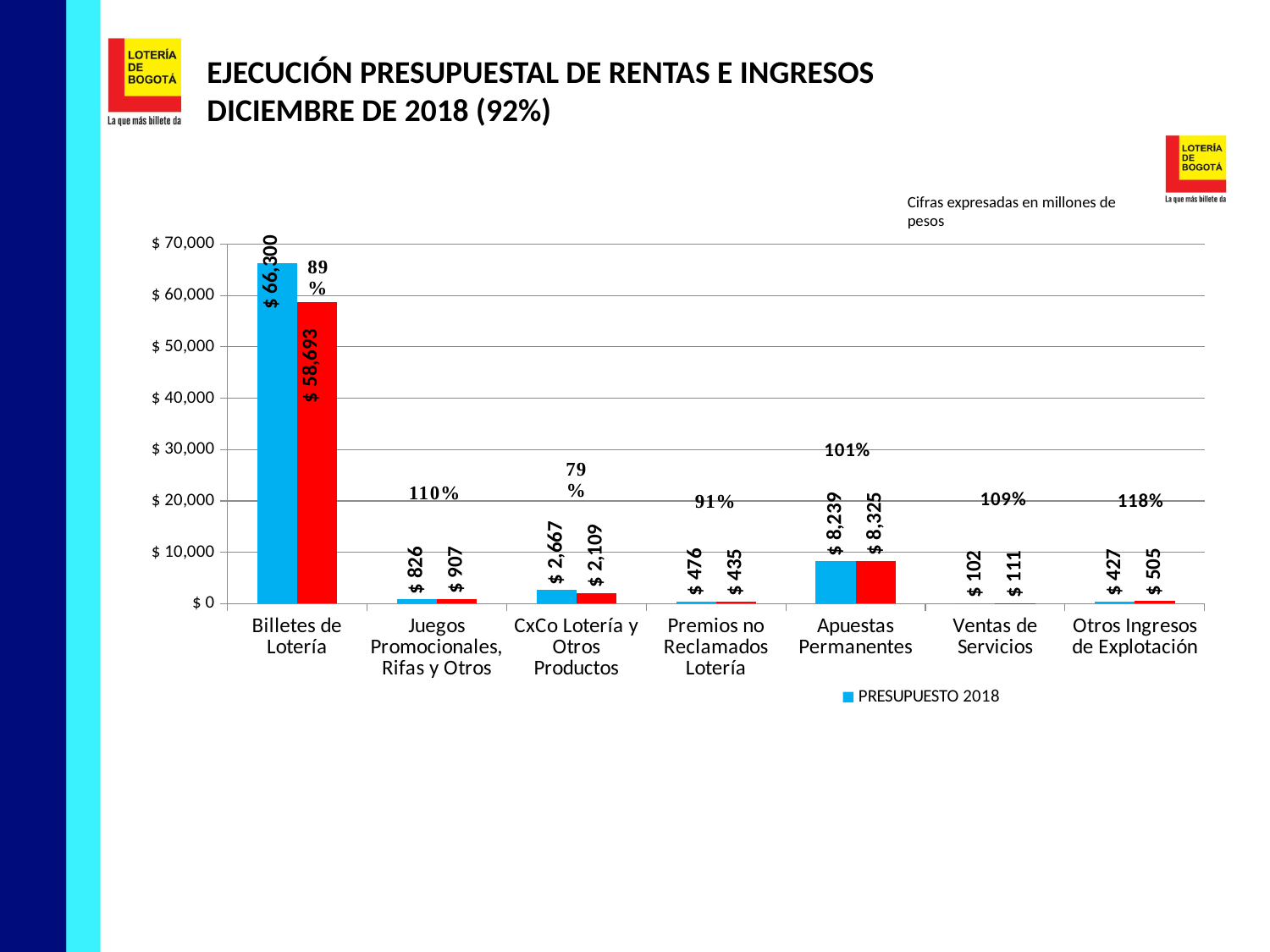
What percentage is shown above the bars for Ventas de Servicios? 109% Which category has the highest PRESUPUESTO 2018 value? Billetes de Lotería What is the value of the red bar for Otros Ingresos de Explotación? $ 505 What kind of chart is shown on the slide? bar chart What is the value of the red bar for Billetes de Lotería? $ 58,693 Which category has the lowest PRESUPUESTO 2018 value? Ventas de Servicios How many categories are shown on the x axis? 7 What is the PRESUPUESTO 2018 value for Billetes de Lotería? $ 66,300 In what units are the figures expressed, according to the note on the slide? millones de pesos What is the PRESUPUESTO 2018 value for Apuestas Permanentes? $ 8,239 What is the difference between the PRESUPUESTO 2018 value and the red bar value for CxCo Lotería y Otros Productos? $ 558 For Juegos Promocionales, Rifas y Otros, which is larger: the PRESUPUESTO 2018 bar or the red bar? the red bar